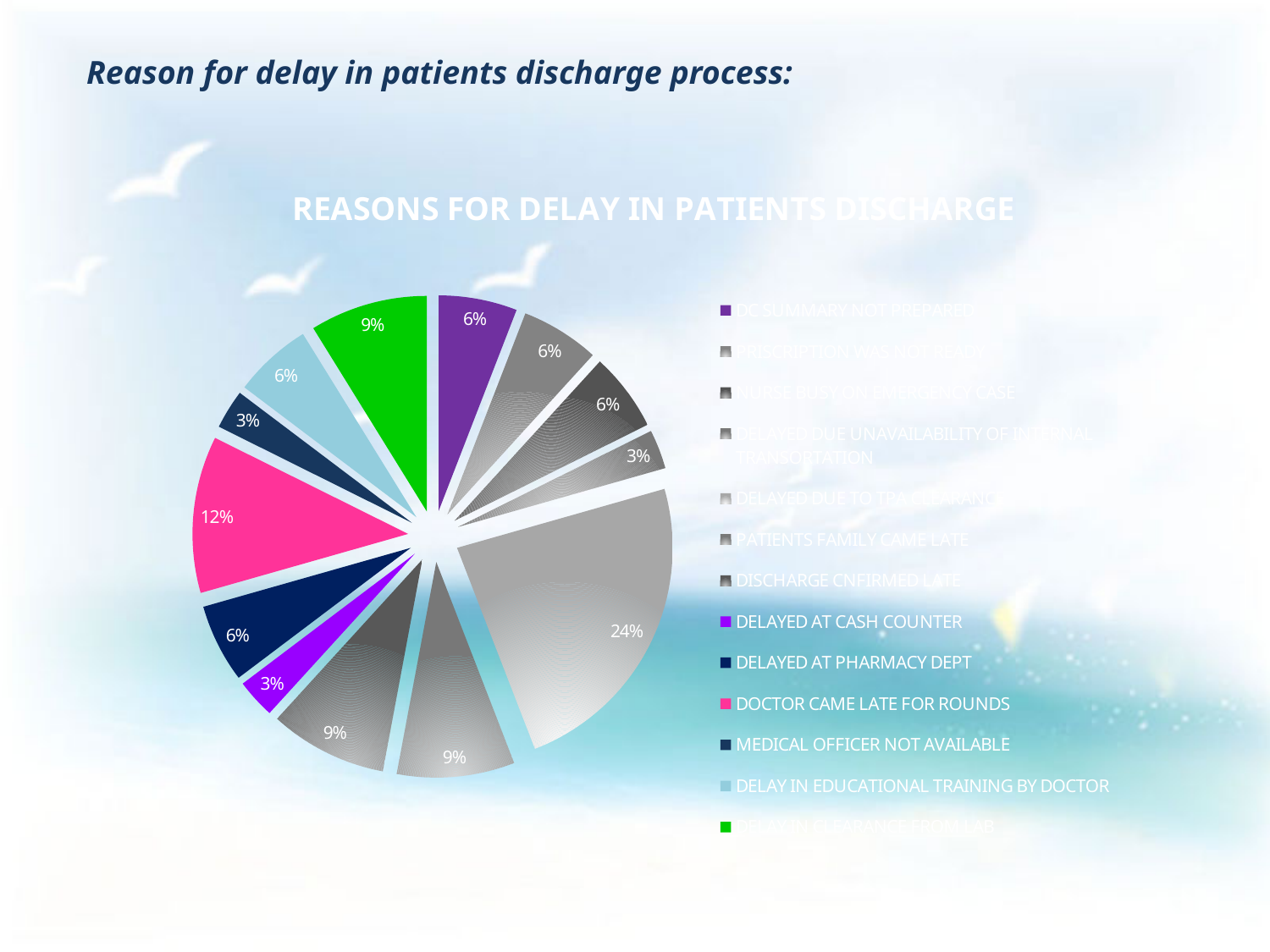
What is the smallest percentage shown on the pie chart? 3% How many slices does the pie chart have? 13 Which is larger, the share for DOCTOR CAME LATE FOR ROUNDS or the share for DELAYED AT PHARMACY DEPT? DOCTOR CAME LATE FOR ROUNDS What percentage is shown for DELAY IN EDUCATIONAL TRAINING BY DOCTOR? 6% What percentage is shown for DELAYED AT PHARMACY DEPT? 6% What is the largest percentage shown on the pie chart? 24% What percentage is shown for DELAYED AT CASH COUNTER? 3% What type of chart is shown on the slide? pie chart What is the title of the chart? REASONS FOR DELAY IN PATIENTS DISCHARGE What is the difference between the share for DOCTOR CAME LATE FOR ROUNDS and the share for MEDICAL OFFICER NOT AVAILABLE? 9% What percentage is shown for DOCTOR CAME LATE FOR ROUNDS? 12% What percentage is shown for DELAY IN CLEARANCE FROM LAB? 9%